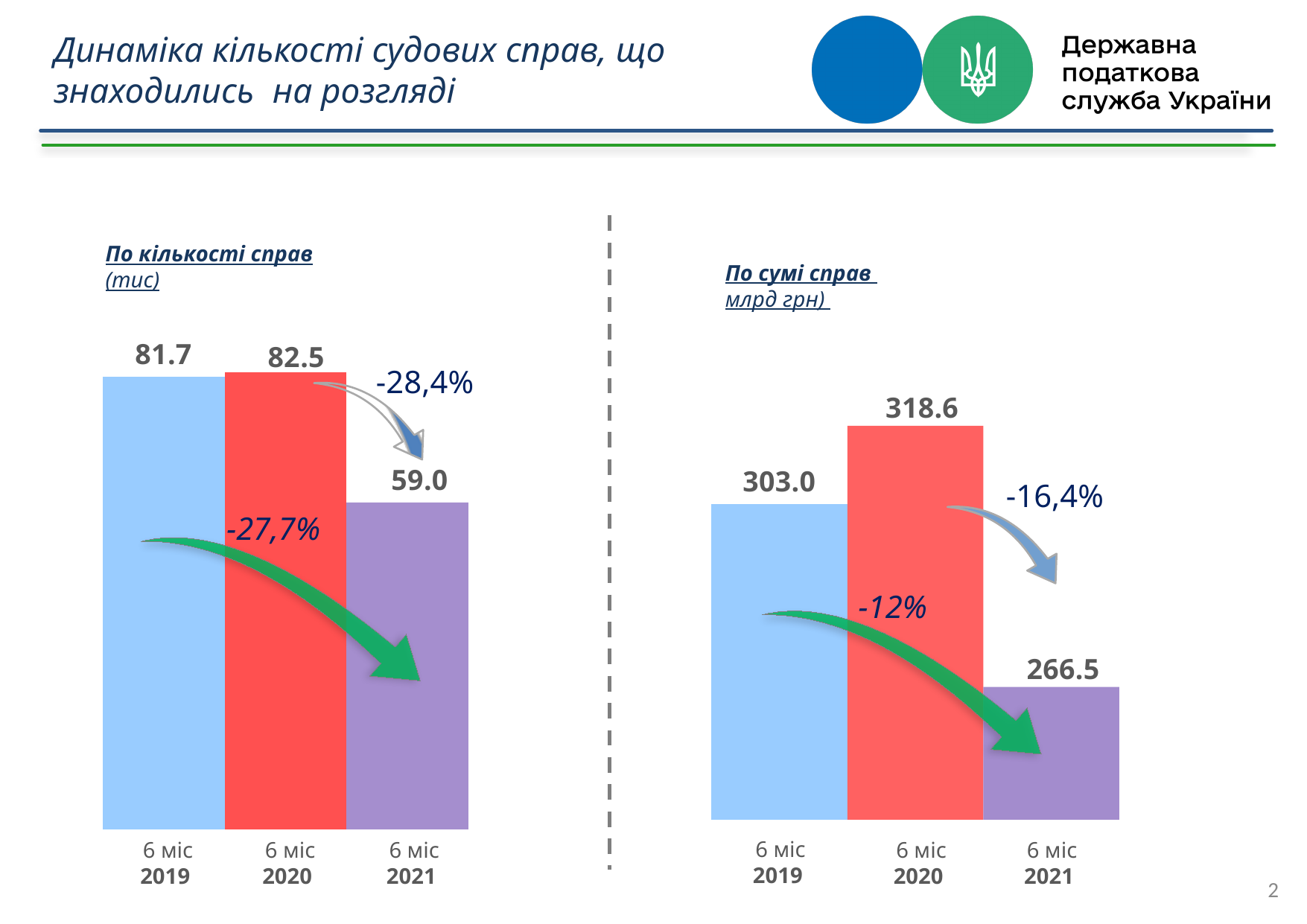
In the right chart (По сумі справ), which period has the lowest value? 6 міс 2021 In the left chart (По кількості справ), which period has the highest value? 6 міс 2020 In the left chart (По кількості справ), what is the value for 6 міс 2019? 81.7 In the right chart (По сумі справ), what is the value for 6 міс 2021? 266.5 In the left chart (По кількості справ), what is the difference between the values for 6 міс 2020 and 6 міс 2021? 23.5 In the right chart (По сумі справ), what is the value for 6 міс 2020? 318.6 In the right chart (По сумі справ), which is larger: the value for 6 міс 2019 or 6 міс 2021? 6 міс 2019 In the right chart (По сумі справ), what percentage change is shown by the arrow from 6 міс 2020 to 6 міс 2021? -16,4% How many bars does the left chart (По кількості справ) have? 3 In the left chart (По кількості справ), what is the value for 6 міс 2021? 59.0 What type of chart is the right chart (По сумі справ)? Bar chart In the right chart (По сумі справ), what is the difference between the values for 6 міс 2020 and 6 міс 2019? 15.6